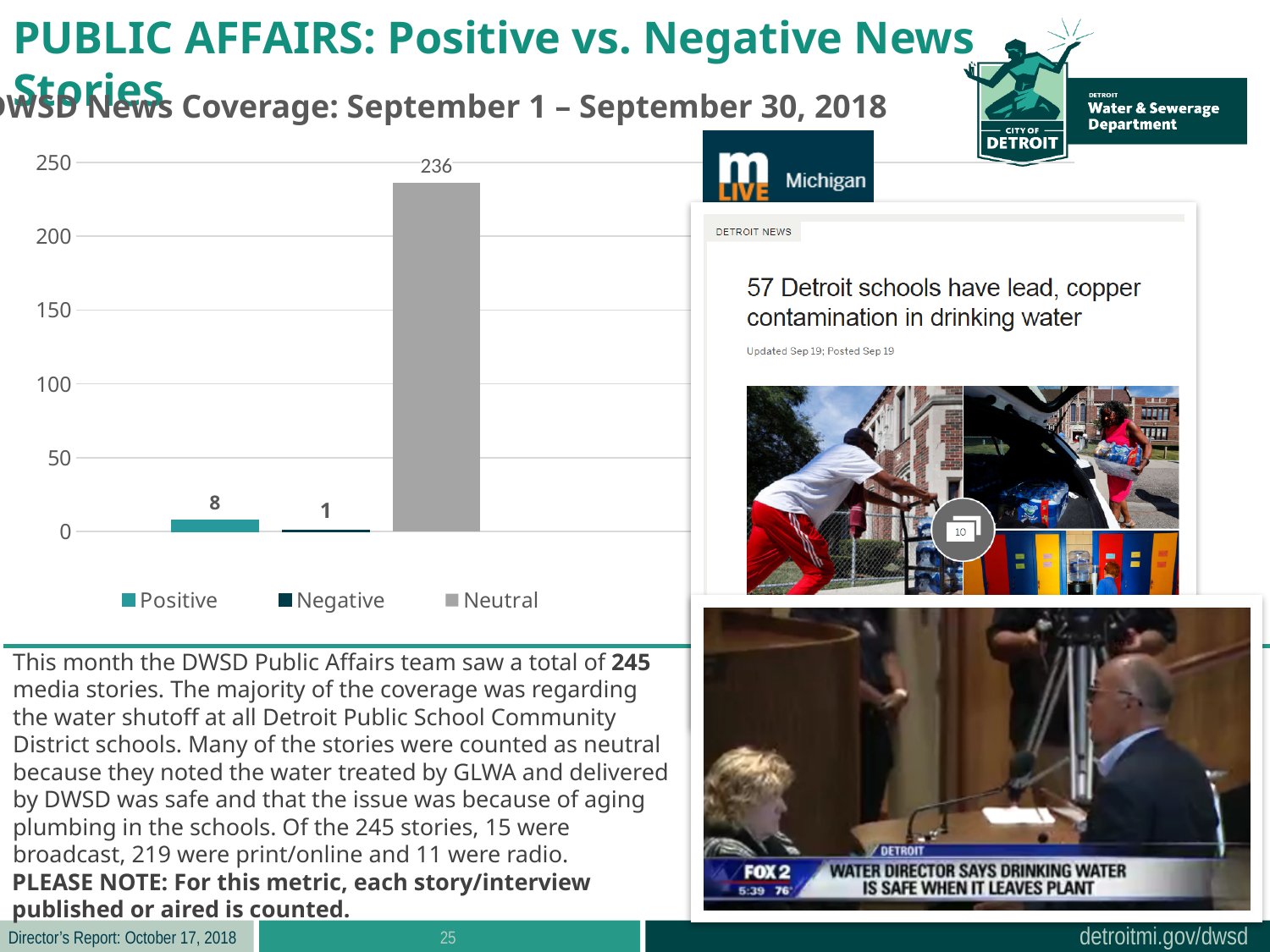
Is the value for Neutral greater or less than 200? greater What is the value for Positive news stories? 8 Which category has the lowest number of news stories? Negative What is the difference between the Positive and Negative values? 7 How many series does the legend list? 3 Which is larger, the Positive value or the Negative value? Positive What is the value for Neutral news stories? 236 What is the total of the Positive, Negative and Neutral values? 245 What kind of chart is shown on the slide? Bar chart What is the value for Negative news stories? 1 What is the difference between the Neutral and Positive values? 228 Which category has the highest number of news stories? Neutral